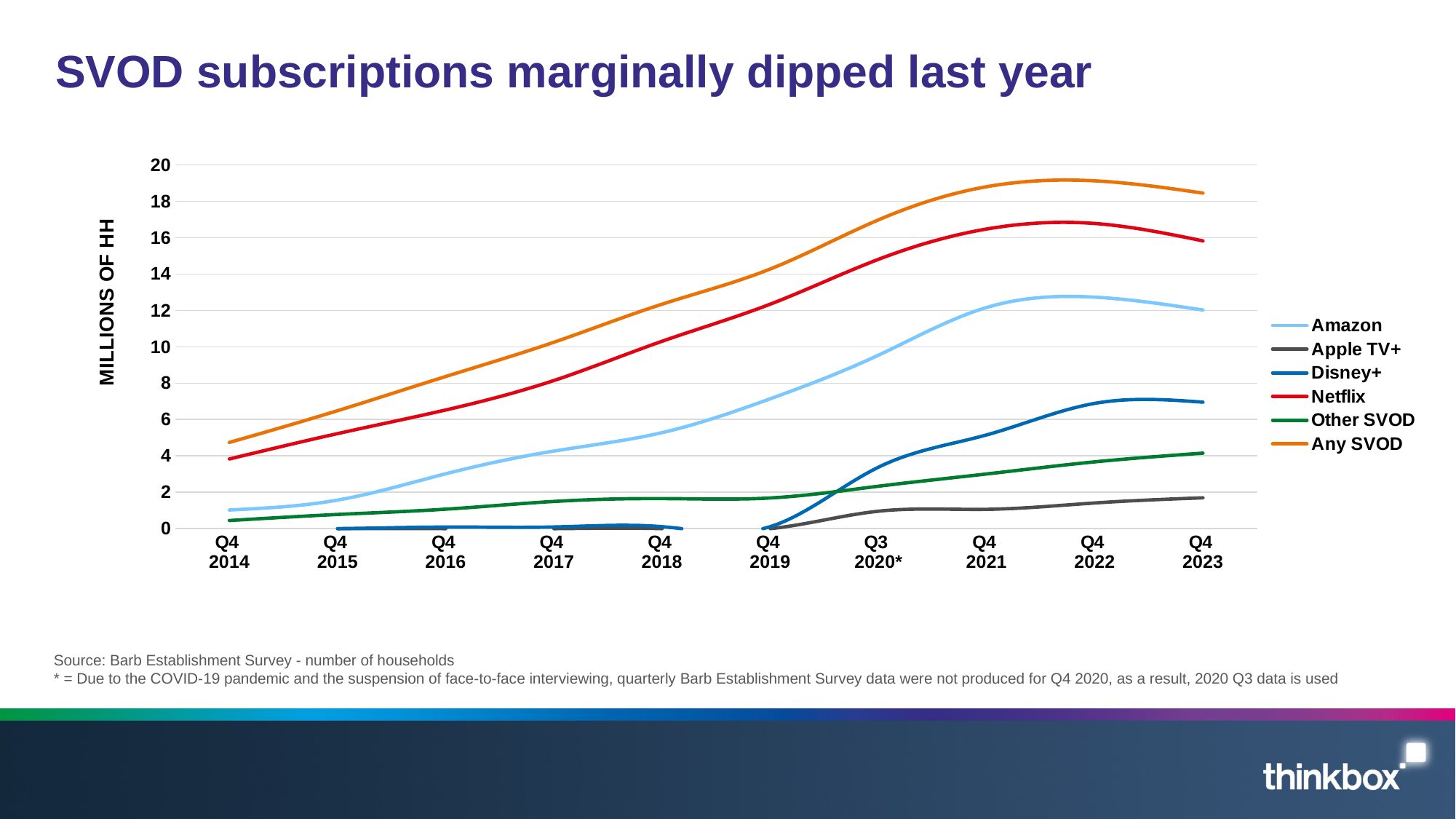
What kind of chart is shown on the slide? Line chart How many time points are shown along the x axis? 10 Is the value for Any SVOD at Q4 2023 greater or less than 16? greater What is the label on the y axis? MILLIONS OF HH Does the Any SVOD line rise or fall between Q4 2022 and Q4 2023? Fall Is the value for Disney+ at Q4 2023 greater or less than 8? less How many series does the legend list? 6 Which series has the highest value at Q4 2023? Any SVOD At Q4 2023, which is larger: Disney+ or Other SVOD? Disney+ Which series has the lowest value at Q4 2023? Apple TV+ Is the value for Amazon at Q4 2023 greater or less than 10? greater At Q4 2023, which is larger: Netflix or Amazon? Netflix